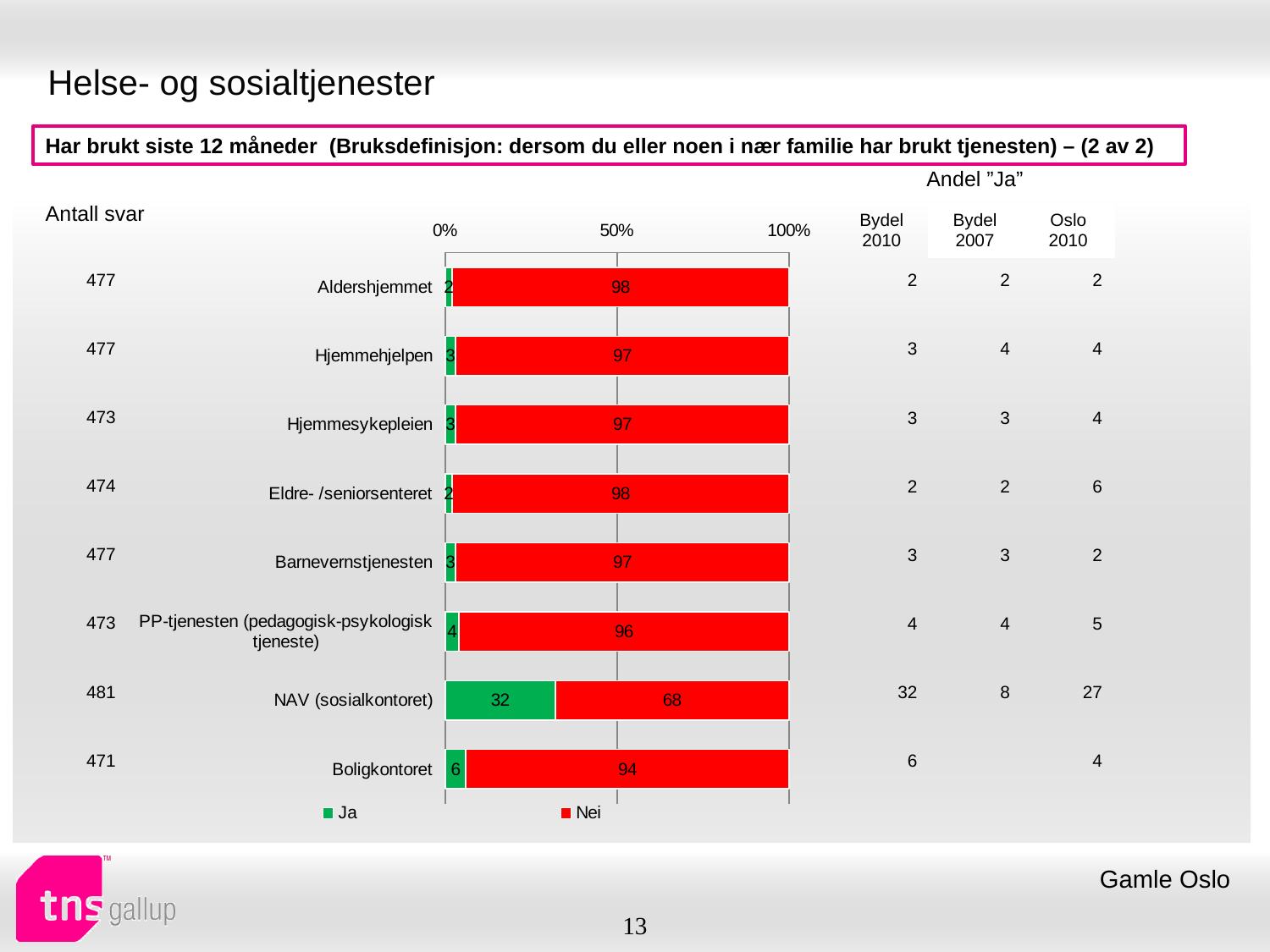
What is the 'Ja' value for Boligkontoret? 6 How many categories are shown in the chart? 8 Which category has the lowest 'Nei' value? NAV (sosialkontoret) Which is larger, the 'Ja' value for Boligkontoret or the 'Ja' value for Hjemmehjelpen? Boligkontoret What is the 'Nei' value for NAV (sosialkontoret)? 68 What is the 'Ja' value for PP-tjenesten (pedagogisk-psykologisk tjeneste)? 4 How many series does the legend list? 2 Is the 'Nei' value for NAV (sosialkontoret) greater or less than 50%? greater Which category has the highest 'Ja' value? NAV (sosialkontoret) What is the difference between the 'Ja' values for NAV (sosialkontoret) and Boligkontoret? 26 What kind of chart is shown on the slide? Stacked bar chart What is the 'Nei' value for Aldershjemmet? 98